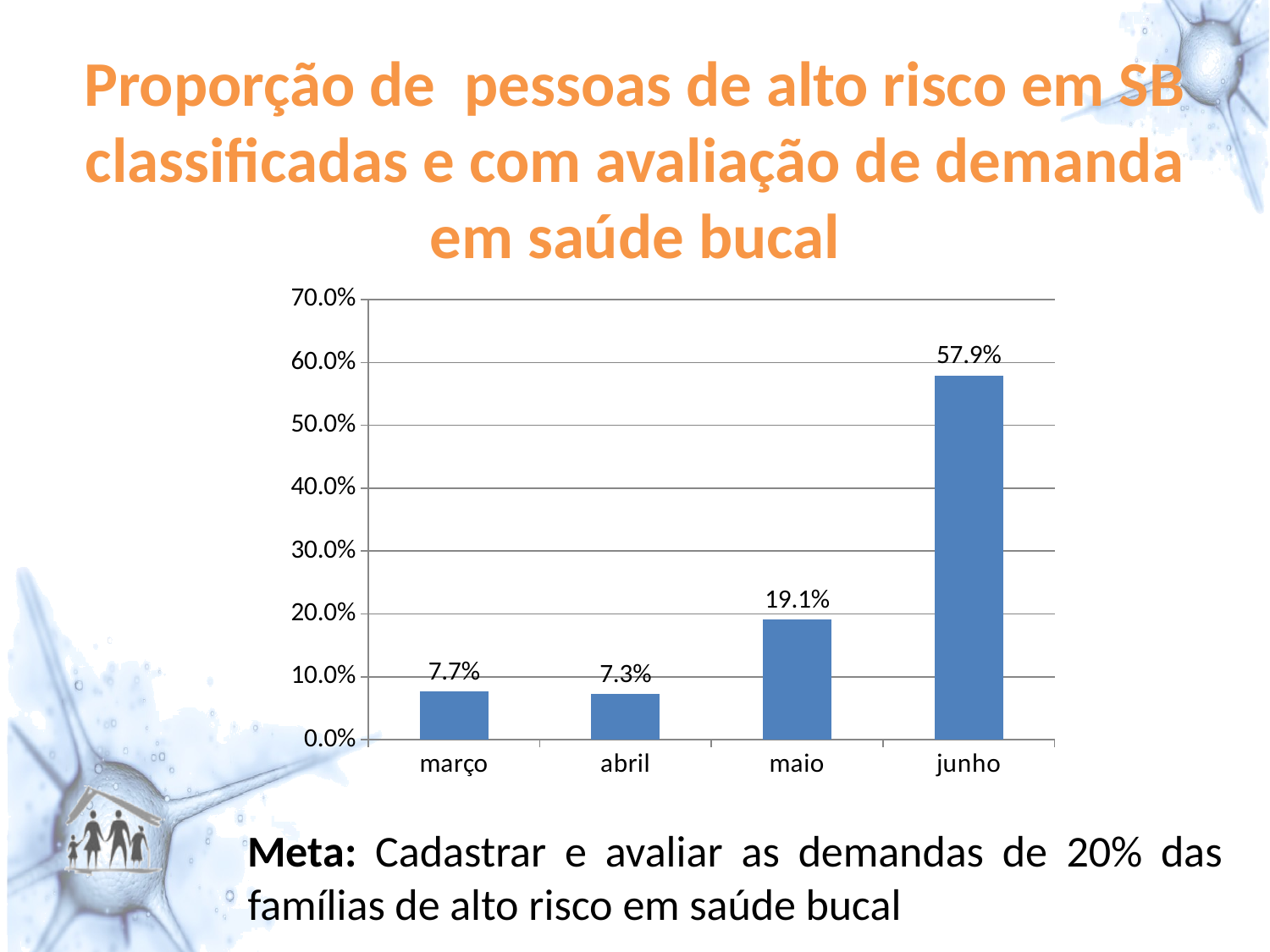
How many months are shown on the x axis? 4 Which month has the highest value? junho What is the difference between the values for junho and maio? 38.8% What is the value for junho? 57.9% Which is larger, the value for maio or the value for abril? maio What kind of chart is shown on the slide? bar chart Do the values rise or fall from abril to junho? rise Which month has the lowest value? abril Is the value for junho greater or less than 50.0%? greater What is the value for maio? 19.1% What is the difference between the values for março and abril? 0.4% What is the value for março? 7.7%